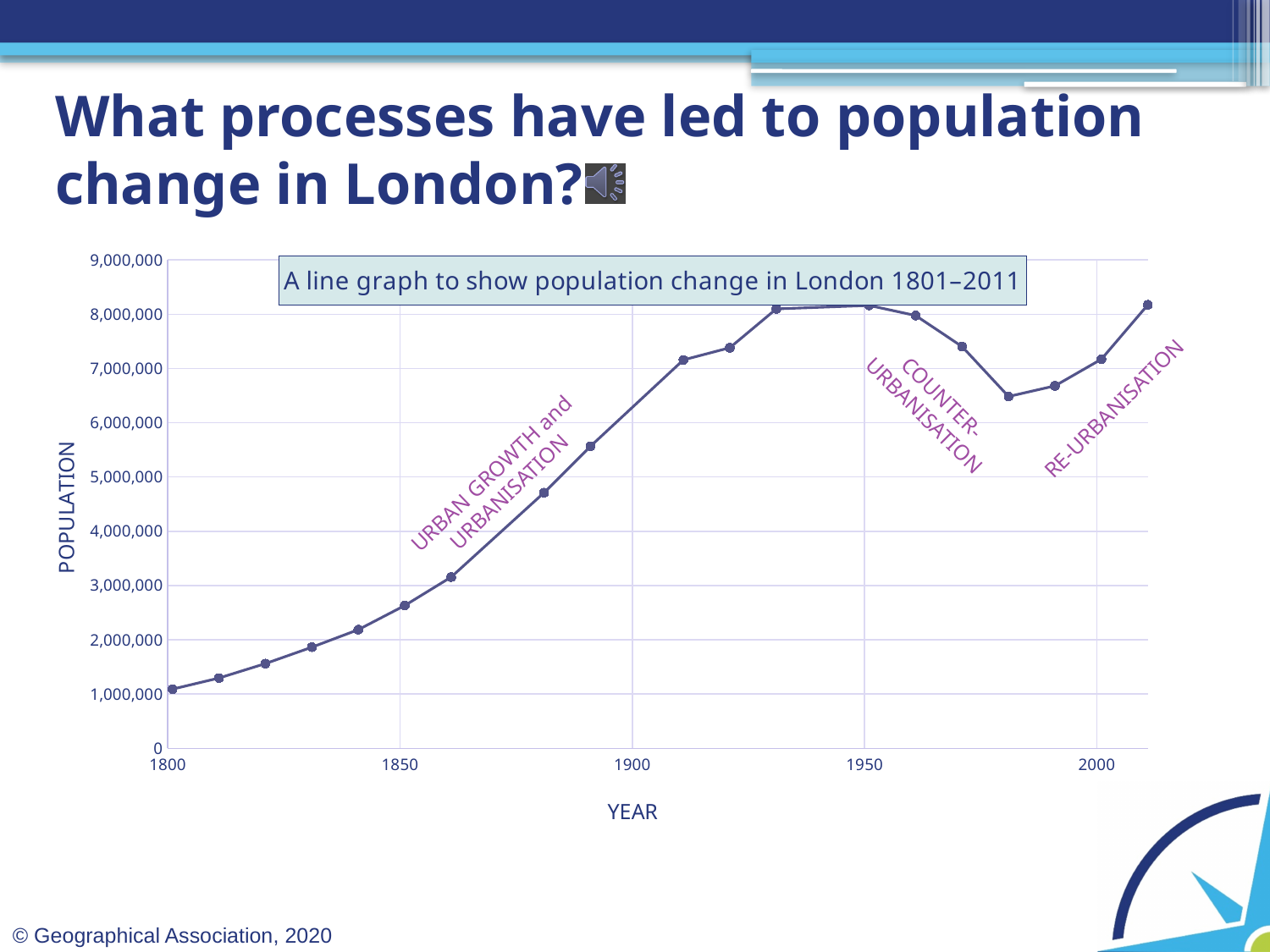
Does the population rise or fall between 1951 and 1981? Fall Is the population value for 1881 greater or less than 5,000,000? less What label is given to the y axis of the chart? POPULATION Does the population rise or fall between 1801 and 1931? Rise What kind of chart is shown on the slide? Line chart Is the population value for 1851 greater or less than 2,000,000? greater Is the population value for 1991 greater or less than 7,000,000? less Which year has the larger population, 1851 or 1951? 1951 What is the title of the chart? A line graph to show population change in London 1801–2011 Which year has the lowest population on the chart? 1801